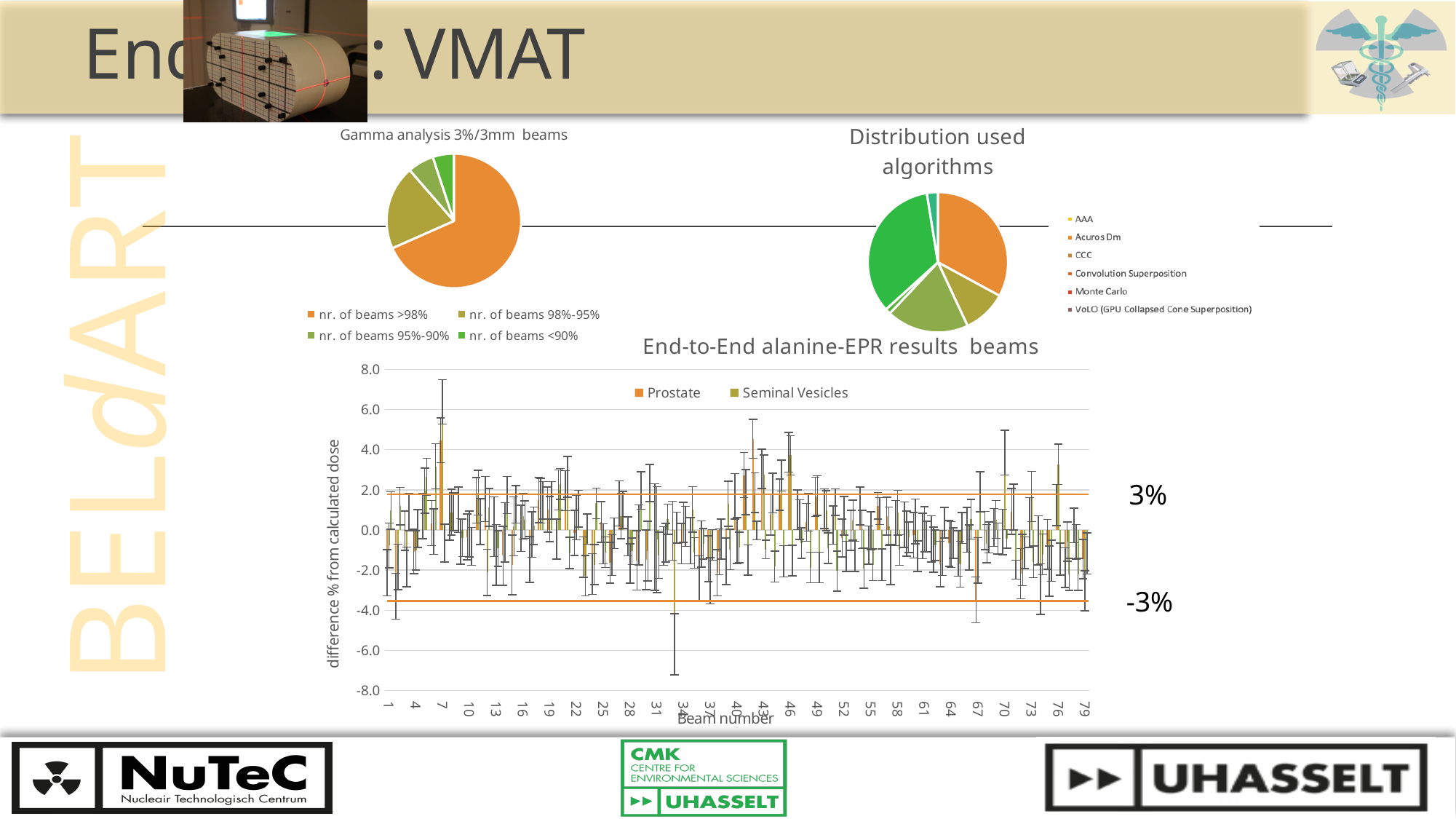
What are the two series named in the legend of the 'End-to-End alanine-EPR results beams' chart? Prostate and Seminal Vesicles How many algorithms does the legend of the 'Distribution used algorithms' pie chart list? 6 What is the y-axis label of the 'End-to-End alanine-EPR results beams' chart? difference % from calculated dose In the 'Gamma analysis 3%/3mm beams' pie chart, which slice is larger: 'nr. of beams >98%' or 'nr. of beams <90%'? nr. of beams >98% In the 'End-to-End alanine-EPR results beams' chart, is the Prostate value for beam 7 greater or less than 2.0? greater How many categories does the legend of the 'Gamma analysis 3%/3mm beams' pie chart list? 4 How many series does the legend of the 'End-to-End alanine-EPR results beams' chart list? 2 What kind of chart is the 'Gamma analysis 3%/3mm beams' chart? pie chart In the 'Gamma analysis 3%/3mm beams' pie chart, which category has the largest slice? nr. of beams >98% In the 'Distribution used algorithms' pie chart, which algorithm is listed first in the legend? AAA What kind of chart is the 'End-to-End alanine-EPR results beams' chart? bar chart In the 'End-to-End alanine-EPR results beams' chart, is the Seminal Vesicles value for beam 34 greater or less than -2.0? greater